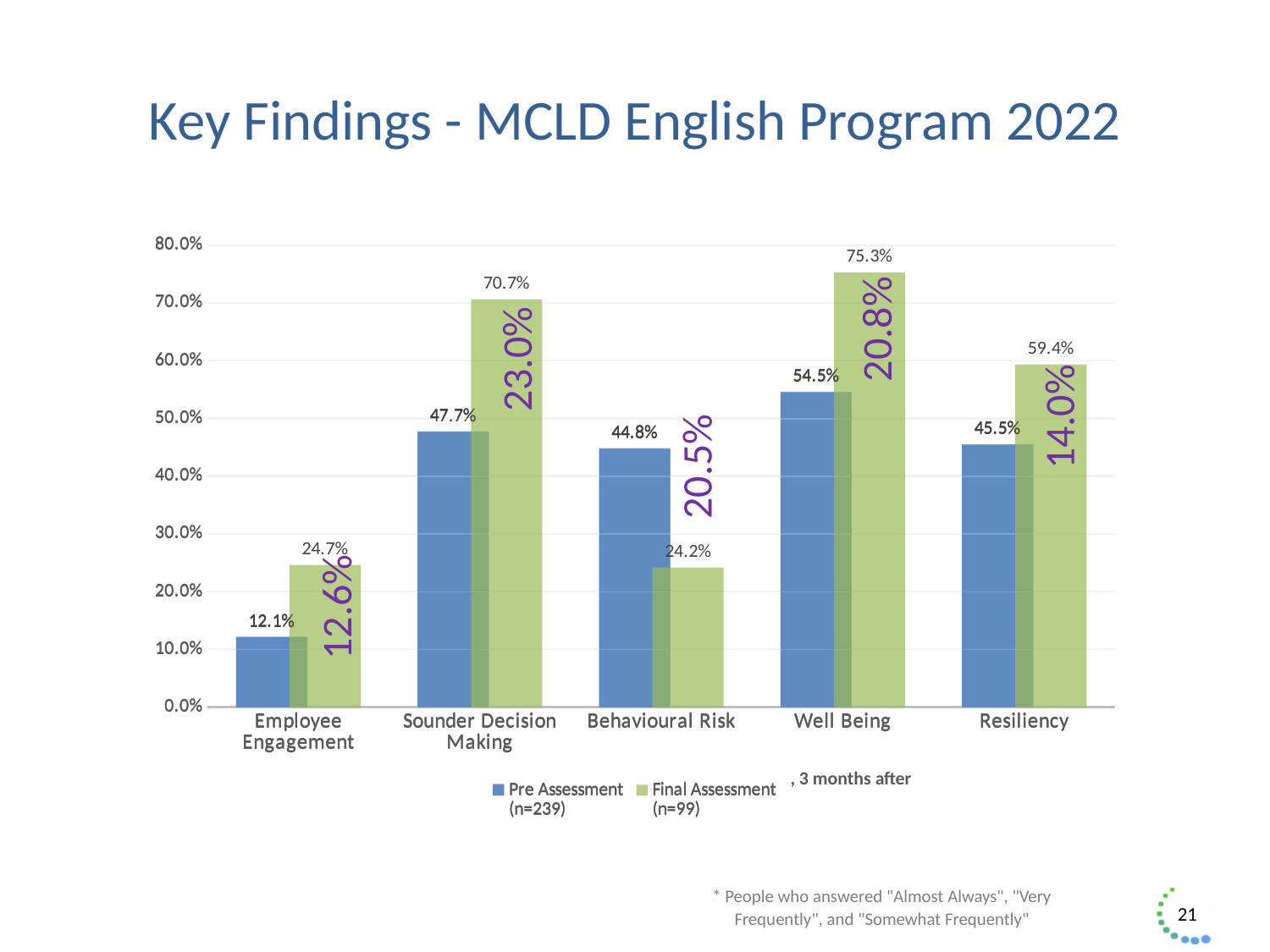
What kind of chart is shown on the slide? Bar chart What is the difference between the Final Assessment and Pre Assessment values for Resiliency? 13.9% What is the Pre Assessment value for Well Being? 54.5% How many categories are shown on the x axis? 5 Which category has the highest Final Assessment value? Well Being What is the sample size (n) given in the legend for the Pre Assessment series? n=239 What is the Final Assessment value for Sounder Decision Making? 70.7% What is the Pre Assessment value for Employee Engagement? 12.1% How many series does the legend list? 2 Which category has the lowest Pre Assessment value? Employee Engagement What is the Final Assessment value for Behavioural Risk? 24.2% Which is larger for Behavioural Risk, the Pre Assessment value or the Final Assessment value? Pre Assessment